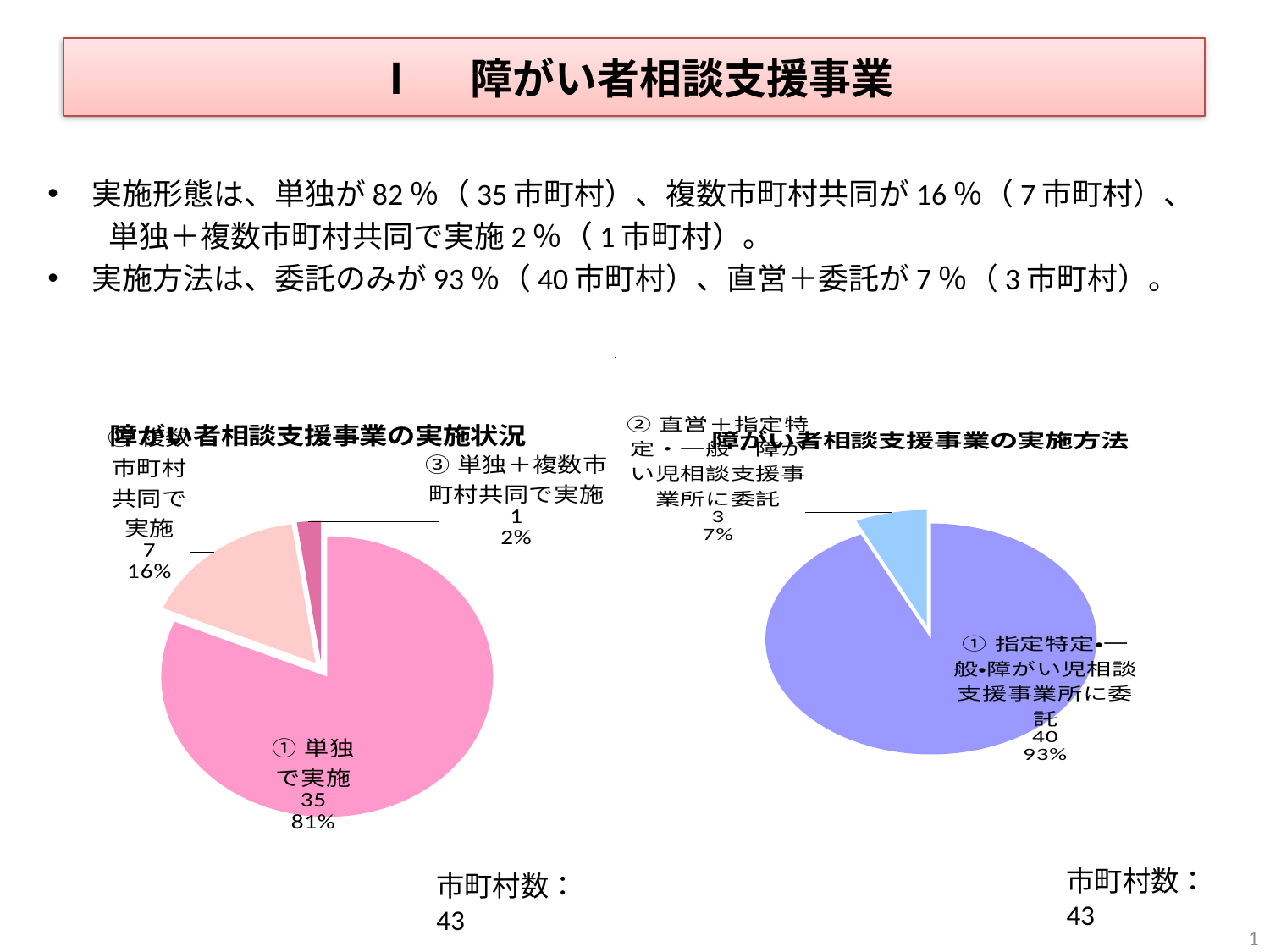
In the left chart titled 障がい者相談支援事業の実施状況, which slice is the largest? ① 単独で実施 In the left chart titled 障がい者相談支援事業の実施状況, what kind of chart is shown? pie chart In the right chart titled 障がい者相談支援事業の実施方法, how many municipalities are in the ① 指定特定・一般・障がい児相談支援事業所に委託 slice? 40 In the right chart titled 障がい者相談支援事業の実施方法, how many slices does the pie have? 2 In the left chart titled 障がい者相談支援事業の実施状況, how many slices does the pie have? 3 In the left chart titled 障がい者相談支援事業の実施状況, what is the difference in municipalities between the ① 単独で実施 slice (35) and the slice with 7 municipalities? 28 In the left chart titled 障がい者相談支援事業の実施状況, what percentage is shown for the ① 単独で実施 slice? 81% In the left chart titled 障がい者相談支援事業の実施状況, how many municipalities are in the ① 単独で実施 slice? 35 In the left chart titled 障がい者相談支援事業の実施状況, what percentage is shown for the ③ 単独＋複数市町村共同で実施 slice? 2% In the right chart titled 障がい者相談支援事業の実施方法, what percentage is shown for the ② 直営＋指定特定・一般・障がい児相談支援事業所に委託 slice? 7% In the right chart titled 障がい者相談支援事業の実施方法, what is the total number of municipalities (市町村数) shown below the chart? 43 In the left chart titled 障がい者相談支援事業の実施状況, which slice is the smallest? ③ 単独＋複数市町村共同で実施